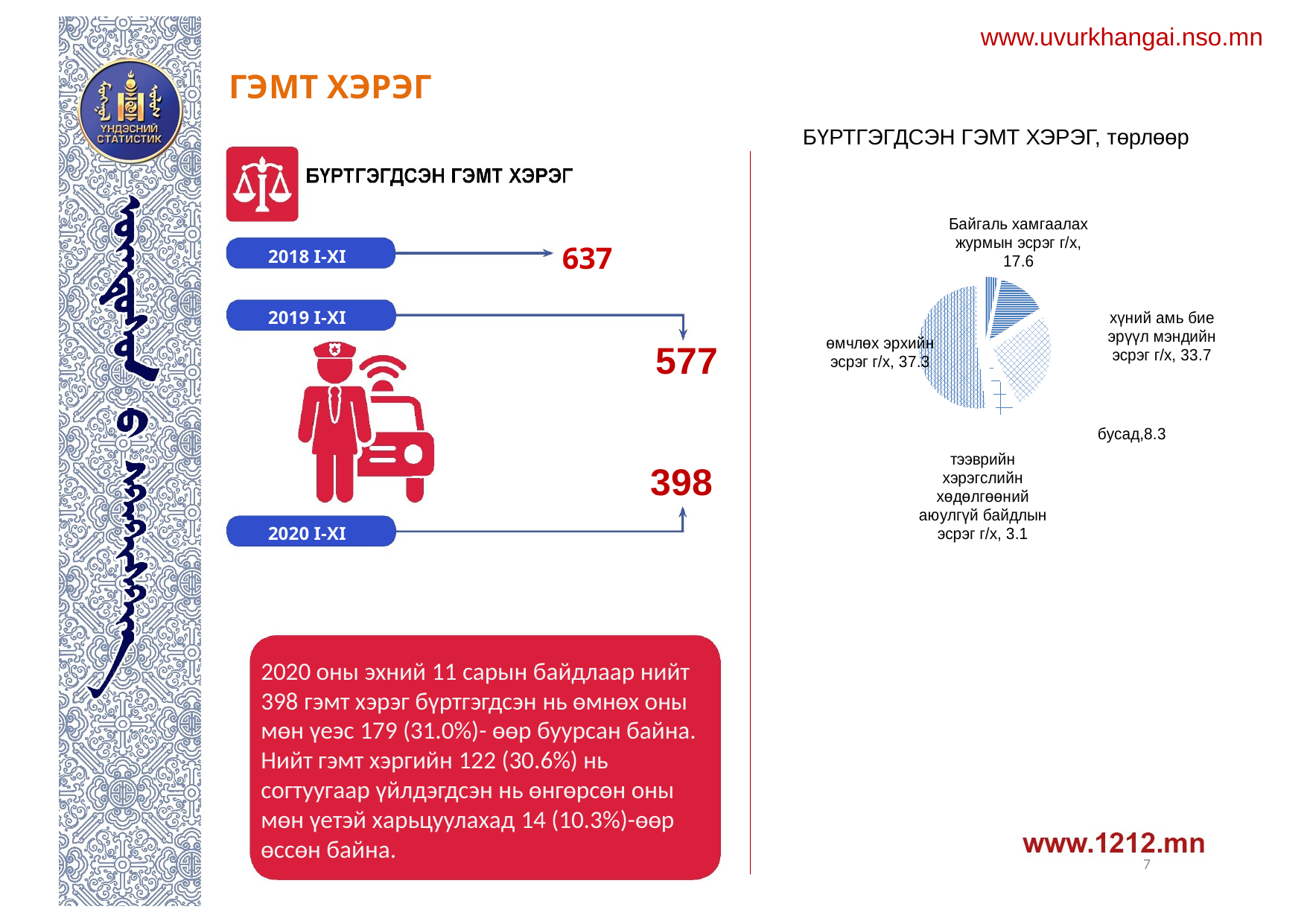
In the pie chart, what value is shown for "Байгаль хамгаалах журмын эсрэг г/х"? 17.6 In the pie chart, what value is shown for "бусад"? 8.3 How many slices does the pie chart "БҮРТГЭГДСЭН ГЭМТ ХЭРЭГ, төрлөөр" have? 5 Which slice of the pie chart has the largest value? өмчлөх эрхийн эсрэг г/х What kind of chart is shown under the title "БҮРТГЭГДСЭН ГЭМТ ХЭРЭГ, төрлөөр"? pie chart In the pie chart, what is the difference between the values for "өмчлөх эрхийн эсрэг г/х" and "хүний амь бие эрүүл мэндийн эсрэг г/х"? 3.6 In the pie chart, what value is shown for "тээврийн хэрэгслийн хөдөлгөөний аюулгүй байдлын эсрэг г/х"? 3.1 Which slice of the pie chart has the smallest value? тээврийн хэрэгслийн хөдөлгөөний аюулгүй байдлын эсрэг г/х What is the title of the pie chart on the right side of the slide? БҮРТГЭГДСЭН ГЭМТ ХЭРЭГ, төрлөөр In the pie chart, which is larger: "Байгаль хамгаалах журмын эсрэг г/х" or "бусад"? Байгаль хамгаалах журмын эсрэг г/х In the pie chart, what value is shown for "хүний амь бие эрүүл мэндийн эсрэг г/х"? 33.7 In the pie chart, what value is shown for "өмчлөх эрхийн эсрэг г/х"? 37.3